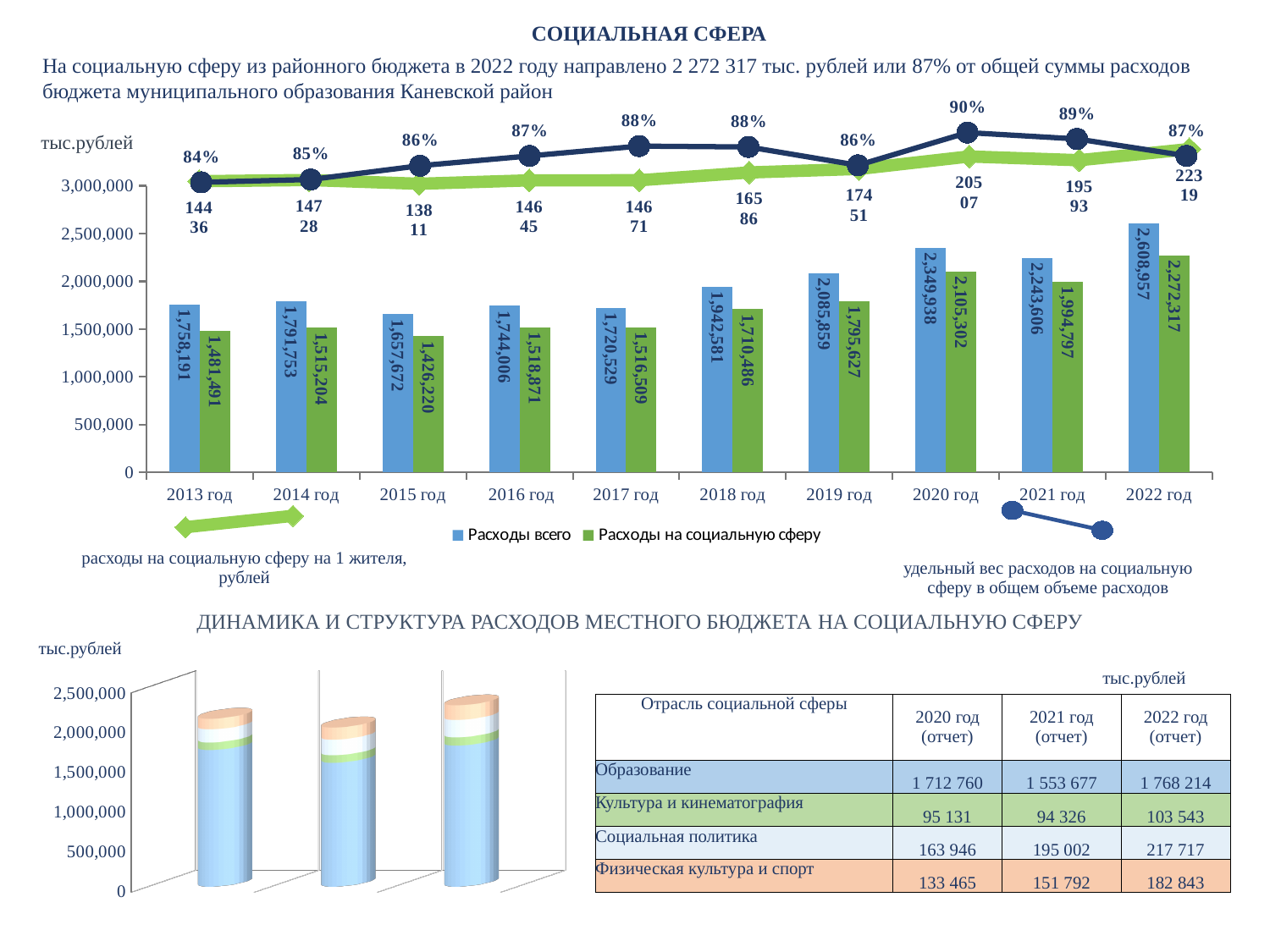
In the top chart, what is the value of Расходы на социальную сферу for 2013 год? 1,481,491 How many years are shown on the x axis of the top chart? 10 In the top chart, what is the share of social expenditure (удельный вес) shown for 2020 год? 90% In the top chart, what is the difference between Расходы всего and Расходы на социальную сферу for 2022 год? 336,640 In the top chart, which year has the highest value of Расходы всего? 2022 год What kind of chart is the top chart? bar chart with line series In the top chart, is the value of Расходы на социальную сферу for 2019 год greater or less than 1,500,000? greater In the top chart, which year has the lowest value of Расходы на социальную сферу? 2015 год In the top chart, which year has the larger value of Расходы всего: 2020 год or 2021 год? 2020 год How many series does the legend of the top chart list? 2 In the top chart, what is the value of Расходы всего for 2022 год? 2,608,957 In the top chart, does the share of social expenditure (удельный вес) rise or fall from 2013 год to 2017 год? rise